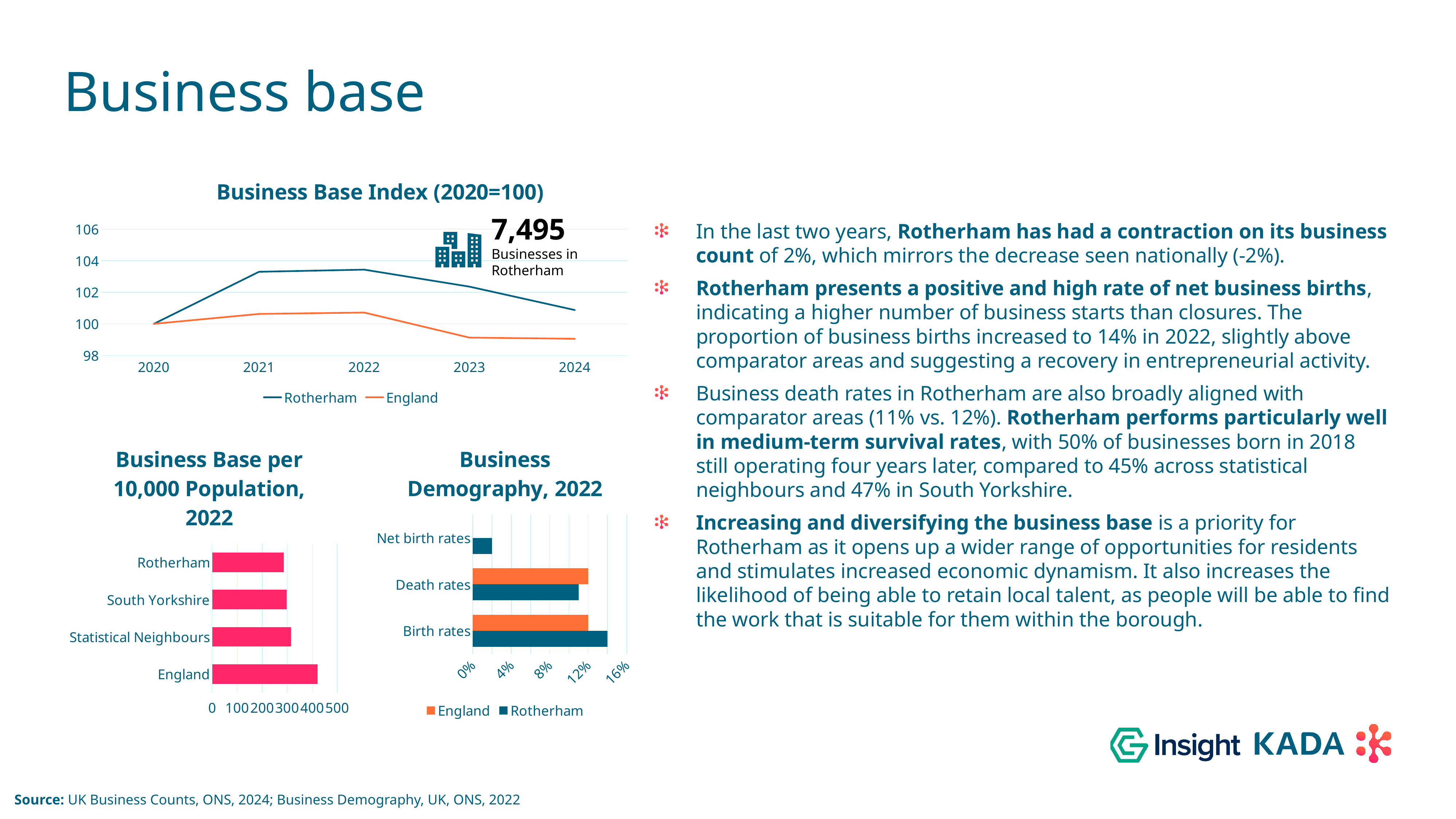
In the Business Demography, 2022 chart, which has the larger Birth rates value: England or Rotherham? Rotherham What kind of chart is the Business Demography, 2022 chart? Bar chart In the Business Base per 10,000 Population, 2022 chart, is the value for England greater or less than 400? greater In the Business Base Index (2020=100) chart, is the England value for 2023 greater or less than 100? less In the Business Base Index (2020=100) chart, is the Rotherham value for 2021 greater or less than 102? greater In the Business Base per 10,000 Population, 2022 chart, which category has the highest value? England How many series does the legend of the Business Base Index (2020=100) chart list? 2 In the Business Base Index (2020=100) chart, does the Rotherham line rise or fall from 2022 to 2024? Fall What kind of chart is the Business Base Index (2020=100) chart? Line chart In the Business Base per 10,000 Population, 2022 chart, which is larger: Rotherham or England? England How many categories are shown in the Business Base per 10,000 Population, 2022 chart? 4